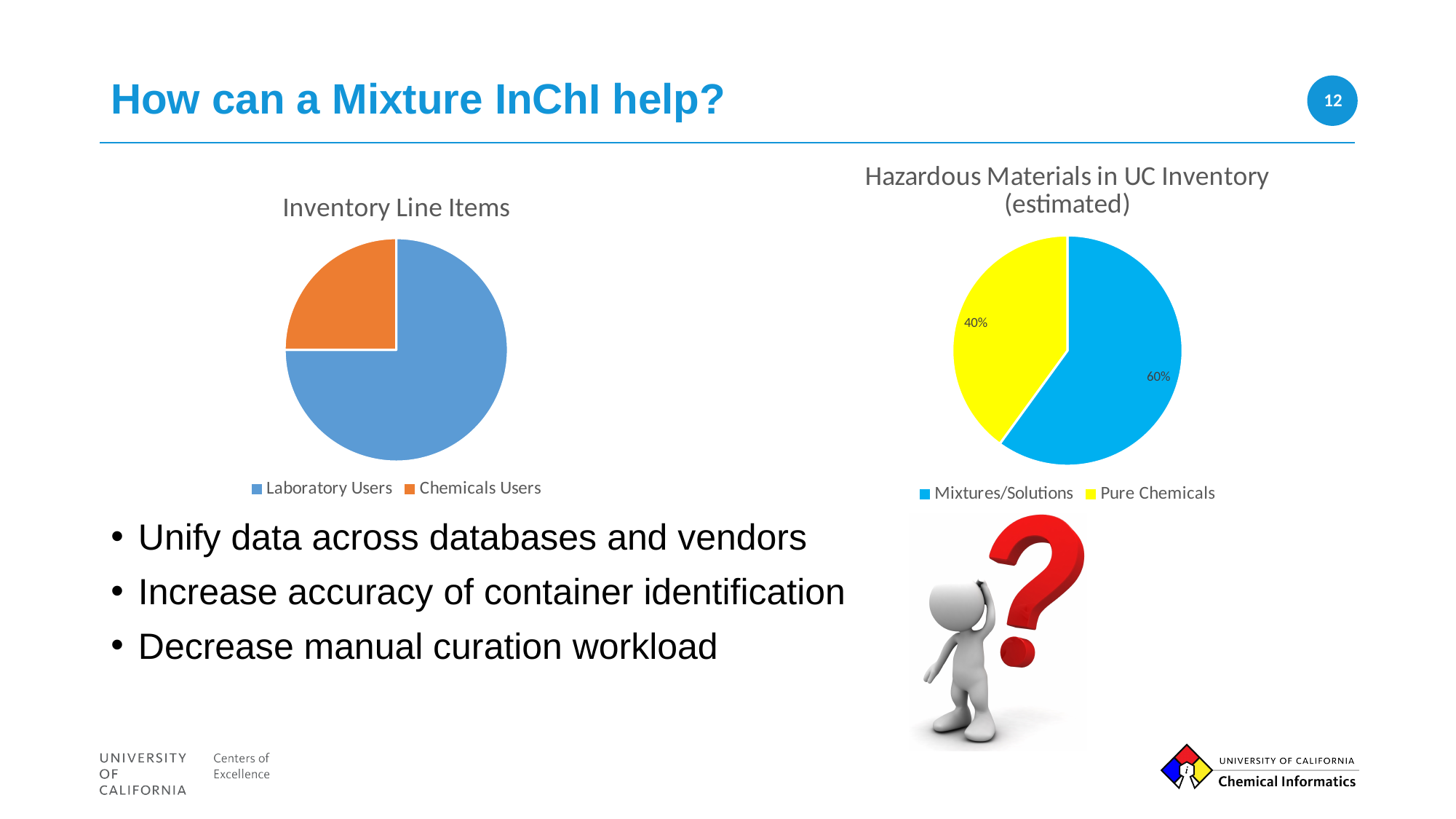
How many slices does the "Hazardous Materials in UC Inventory (estimated)" chart have? 2 In the "Inventory Line Items" chart, which slice is larger, Laboratory Users or Chemicals Users? Laboratory Users What kind of chart is the "Hazardous Materials in UC Inventory (estimated)" chart? Pie chart In the "Hazardous Materials in UC Inventory (estimated)" chart, which category has the largest slice? Mixtures/Solutions In the "Inventory Line Items" chart, which category has the smallest slice? Chemicals Users How many categories does the legend of the "Inventory Line Items" chart list? 2 In the "Inventory Line Items" chart, which category has the largest slice? Laboratory Users What kind of chart is the "Inventory Line Items" chart? Pie chart In the "Hazardous Materials in UC Inventory (estimated)" chart, what colour is the Pure Chemicals slice? Yellow In the "Hazardous Materials in UC Inventory (estimated)" chart, what share is Mixtures/Solutions? 60% In the "Hazardous Materials in UC Inventory (estimated)" chart, what share is Pure Chemicals? 40% In the "Hazardous Materials in UC Inventory (estimated)" chart, what is the difference between the Mixtures/Solutions and Pure Chemicals shares? 20%